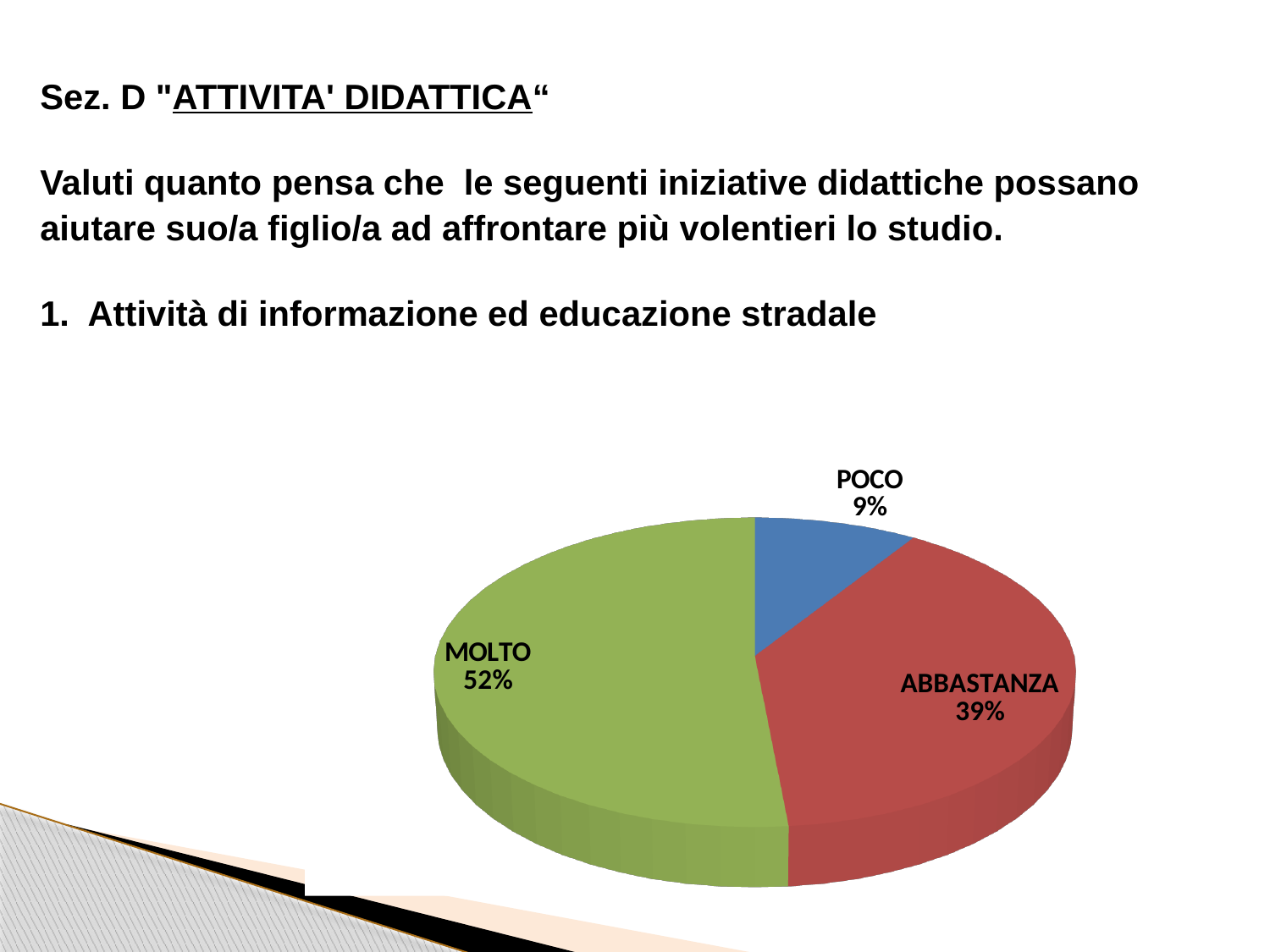
What colour is the POCO slice of the pie? blue What is the difference in percentage points between the MOLTO and ABBASTANZA slices? 13 What is the difference in percentage points between the ABBASTANZA and POCO slices? 30 What percentage of the pie is labelled POCO? 9% What kind of chart is shown on the slide? pie chart What percentage of the pie is labelled ABBASTANZA? 39% How many slices does the pie chart have? 3 What colour is the MOLTO slice of the pie? green Which slice is larger, ABBASTANZA or POCO? ABBASTANZA Which slice of the pie is the smallest? POCO What percentage of the pie is labelled MOLTO? 52% Which slice of the pie is the largest? MOLTO